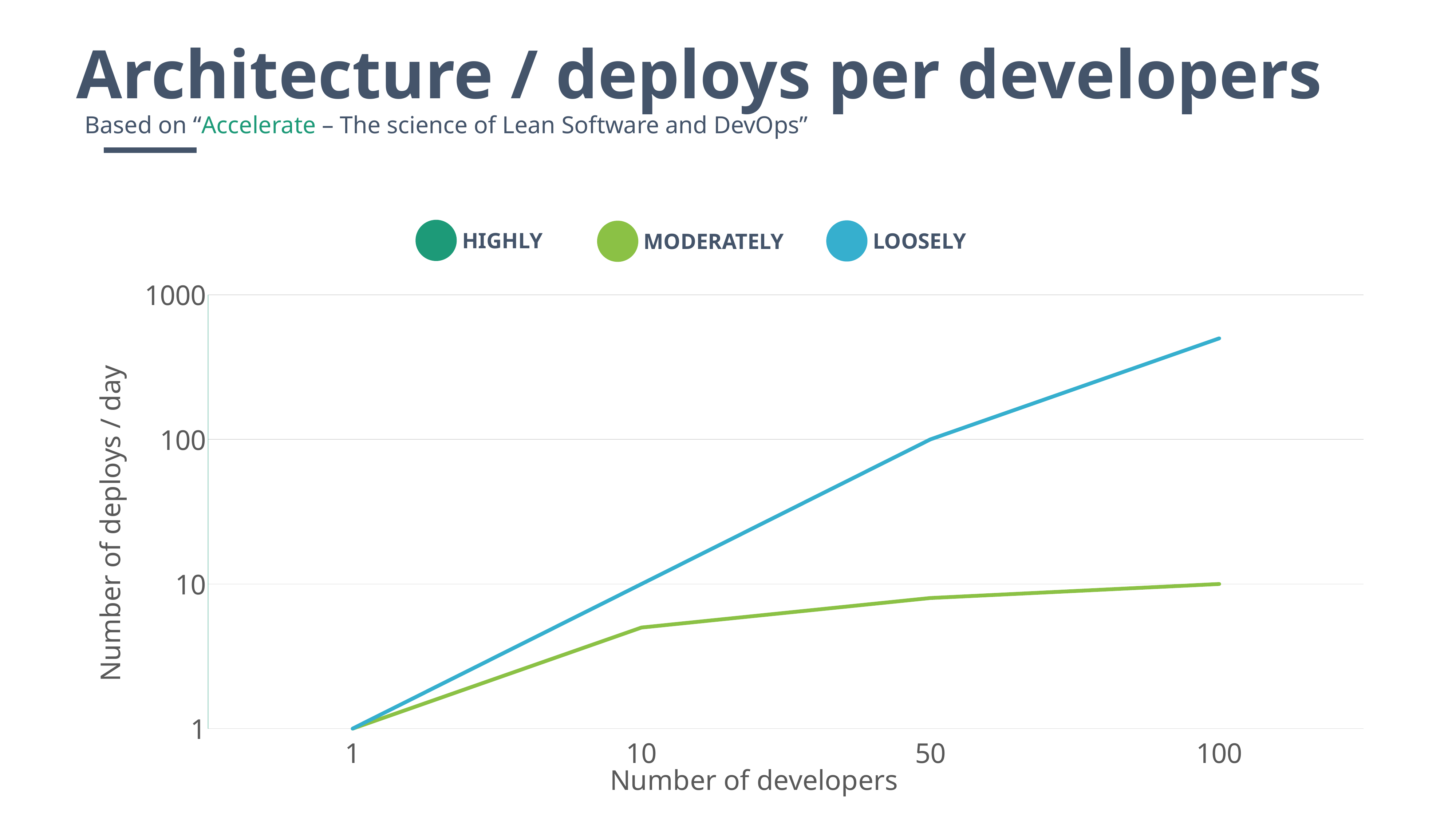
What is the number of deploys per day for the LOOSELY series at 1 developer? 1 At 100 developers, which series has the higher number of deploys per day, LOOSELY or MODERATELY? LOOSELY Is the value for the LOOSELY series at 100 developers greater or less than 100? greater What is the number of deploys per day for the LOOSELY series at 50 developers? 100 Is the value for the LOOSELY series at 100 developers greater or less than 1000? less How many tick values are labelled on the x axis (Number of developers)? 4 Is the value for the MODERATELY series at 50 developers greater or less than 10? less How many series does the legend list? 3 What is the title of the y axis? Number of deploys / day What kind of chart is shown on the slide? line chart What is the number of deploys per day for the MODERATELY series at 100 developers? 10 Does the LOOSELY series rise or fall as the number of developers increases? rise